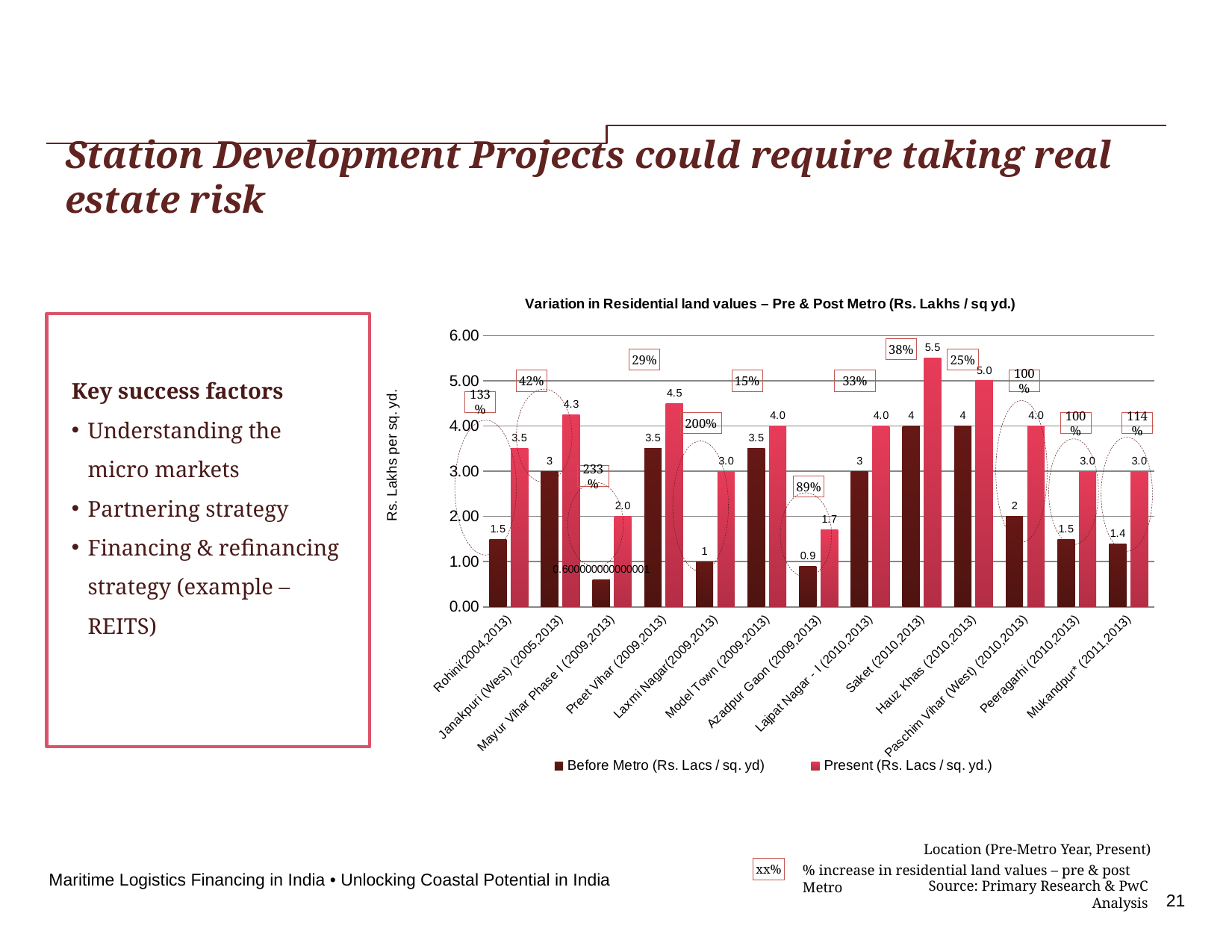
How many series does the legend list? 2 How many locations are shown on the x axis? 13 What is the Before Metro value for Rohini(2004,2013)? 1.5 What is the Present value for Azadpur Gaon (2009,2013)? 1.7 Which location has the highest Present (Rs. Lacs / sq. yd.) value? Saket (2010,2013) Which is larger for Hauz Khas (2010,2013): the Before Metro value or the Present value? Present Is the Before Metro value for Laxmi Nagar(2009,2013) greater or less than 2.00? less What is the title of the chart? Variation in Residential land values – Pre & Post Metro (Rs. Lakhs / sq yd.) What is the Present (Rs. Lacs / sq. yd.) value for Saket (2010,2013)? 5.5 Which location has the lowest Present (Rs. Lacs / sq. yd.) value? Azadpur Gaon (2009,2013) What type of chart is shown on the slide? bar chart What is the difference between the Present and Before Metro values for Preet Vihar (2009,2013)? 1.0